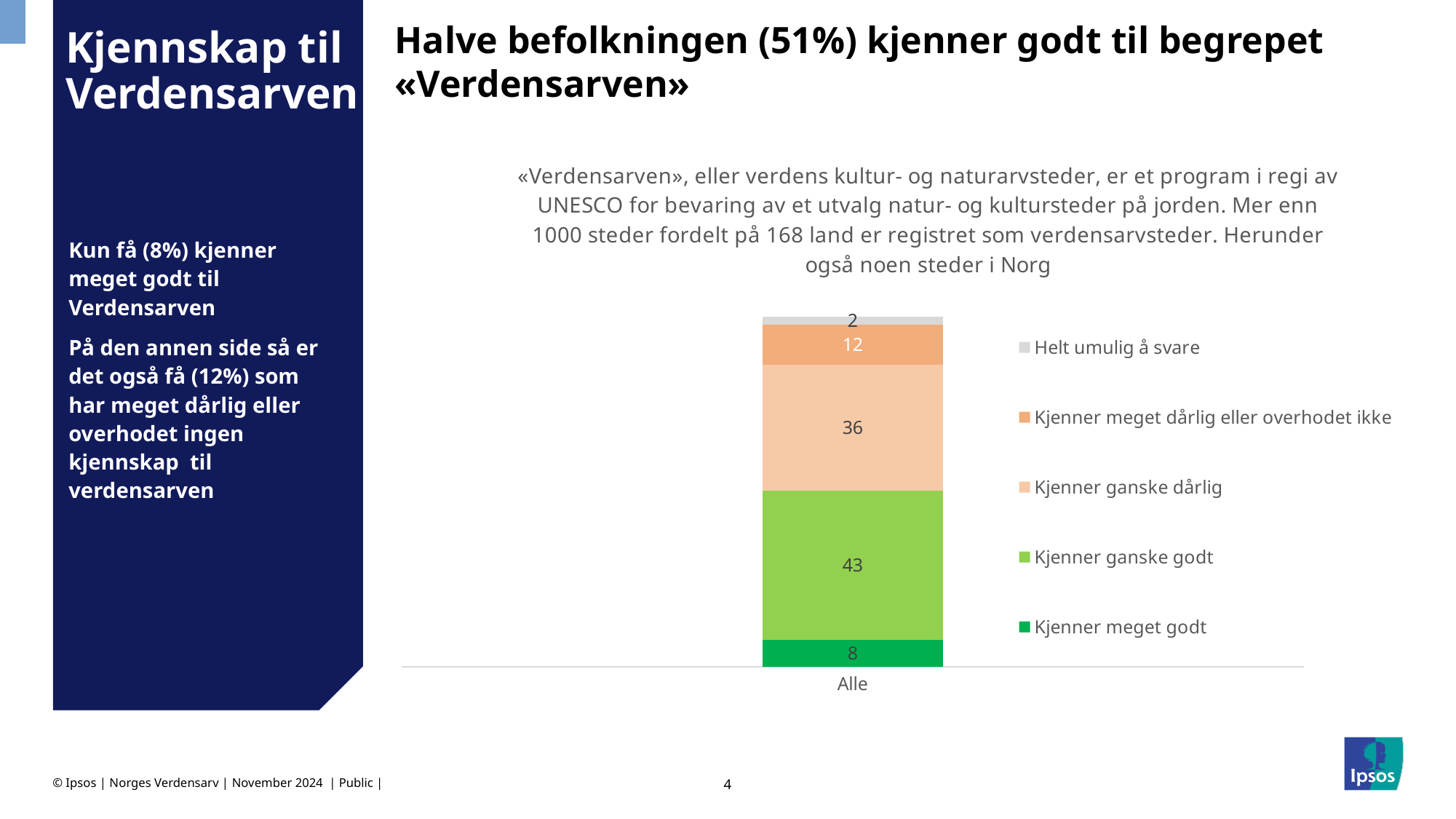
How many series does the legend list? 5 What is the total of the stacked "Alle" bar? 101 What is the value for "Kjenner ganske godt" in the "Alle" bar? 43 Which series has the largest segment in the "Alle" bar? Kjenner ganske godt What is the value for "Kjenner meget dårlig eller overhodet ikke" in the "Alle" bar? 12 What is the value for "Kjenner meget godt" in the "Alle" bar? 8 What kind of chart is shown on the slide? Stacked bar chart Which series has the smallest segment in the "Alle" bar? Helt umulig å svare Which is larger: "Kjenner meget dårlig eller overhodet ikke" or "Kjenner meget godt"? Kjenner meget dårlig eller overhodet ikke What is the difference between the "Kjenner ganske godt" and "Kjenner ganske dårlig" values? 7 What is the value for "Helt umulig å svare" in the "Alle" bar? 2 What is the value for "Kjenner ganske dårlig" in the "Alle" bar? 36